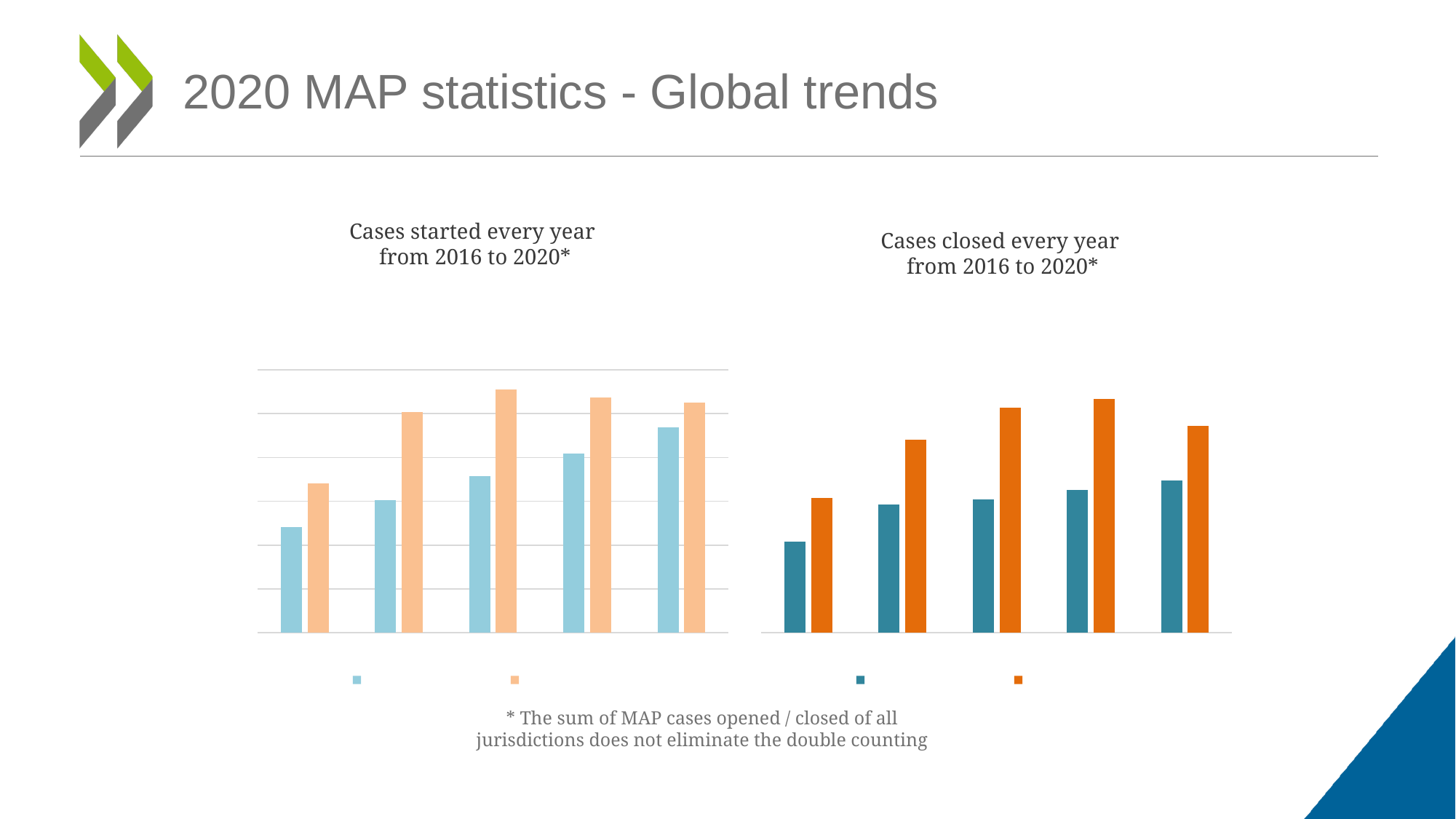
In the "Cases started every year from 2016 to 2020*" chart, in the leftmost group, which bar is taller, the light blue one or the light orange one? the light orange one In the "Cases closed every year from 2016 to 2020*" chart, how many groups of bars are plotted? 5 In the "Cases started every year from 2016 to 2020*" chart, how many groups of bars are plotted? 5 In the "Cases started every year from 2016 to 2020*" chart, which group of bars has the shortest light blue bar? the first (leftmost) group In the "Cases closed every year from 2016 to 2020*" chart, which group of bars has the tallest orange bar? the fourth group from the left In the "Cases started every year from 2016 to 2020*" chart, do the light blue bars rise or fall from left to right? rise In the "Cases closed every year from 2016 to 2020*" chart, how many series does the legend show? 2 What kind of chart is the "Cases closed every year from 2016 to 2020*" chart? bar chart In the "Cases closed every year from 2016 to 2020*" chart, do the dark teal bars rise or fall from left to right? rise In the "Cases started every year from 2016 to 2020*" chart, how many series does the legend show? 2 What kind of chart is the "Cases started every year from 2016 to 2020*" chart? bar chart What is the title of the chart on the right side of the slide? Cases closed every year from 2016 to 2020*